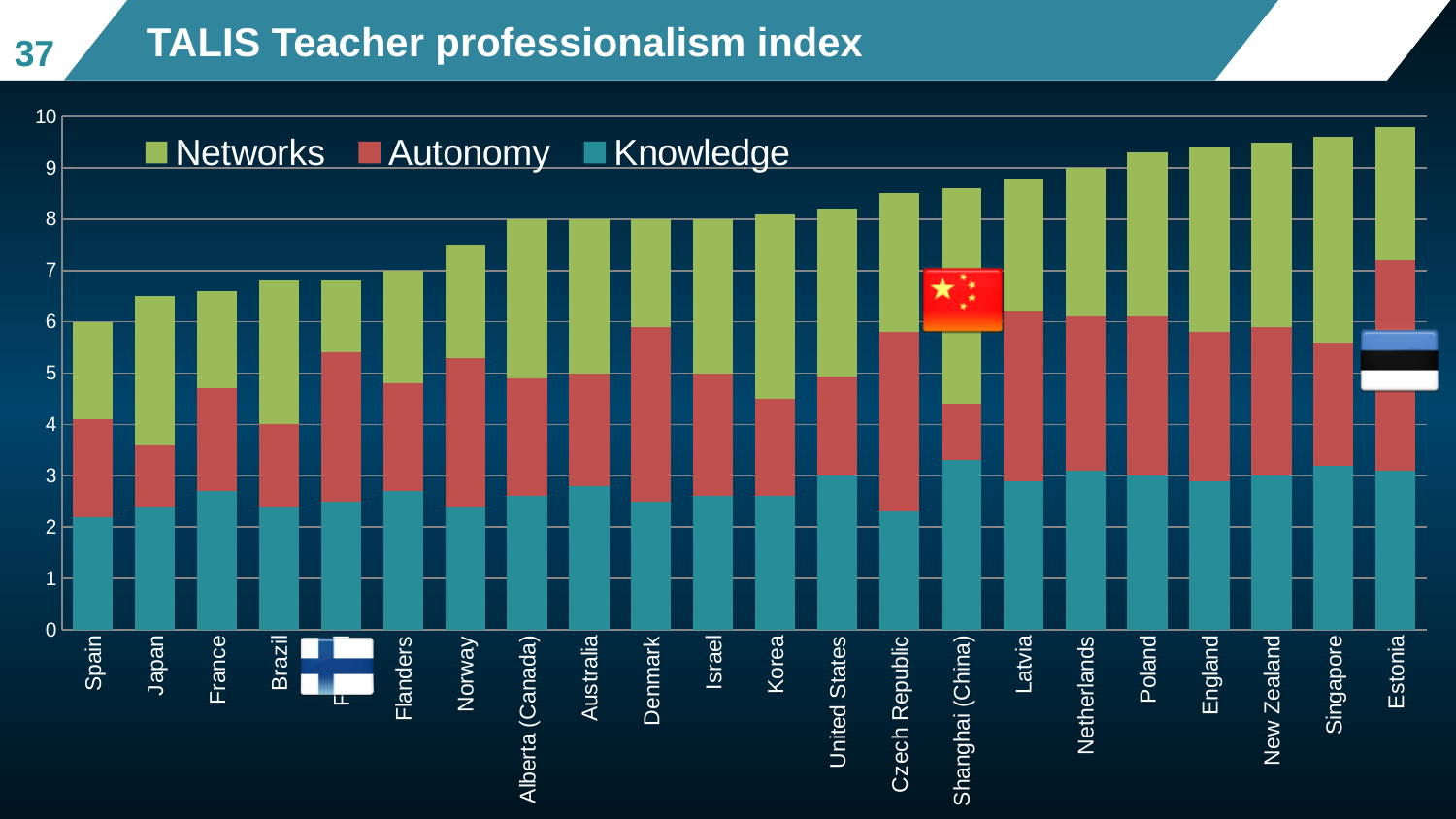
Which series is shown at the bottom of each stacked bar? Knowledge Is the total value for Norway greater or less than 8? less Which country has the highest total teacher professionalism index? Estonia Which has a larger total index, Singapore or Japan? Singapore Is the total value for Latvia greater or less than 8? greater Do the total bar heights rise or fall moving from left to right along the x axis? rise Is the total value for Estonia greater or less than 9? greater What kind of chart is shown on the slide? stacked bar chart How many countries or regions are plotted along the x axis? 22 How many series does the legend list? 3 Which country has the lowest total teacher professionalism index? Spain